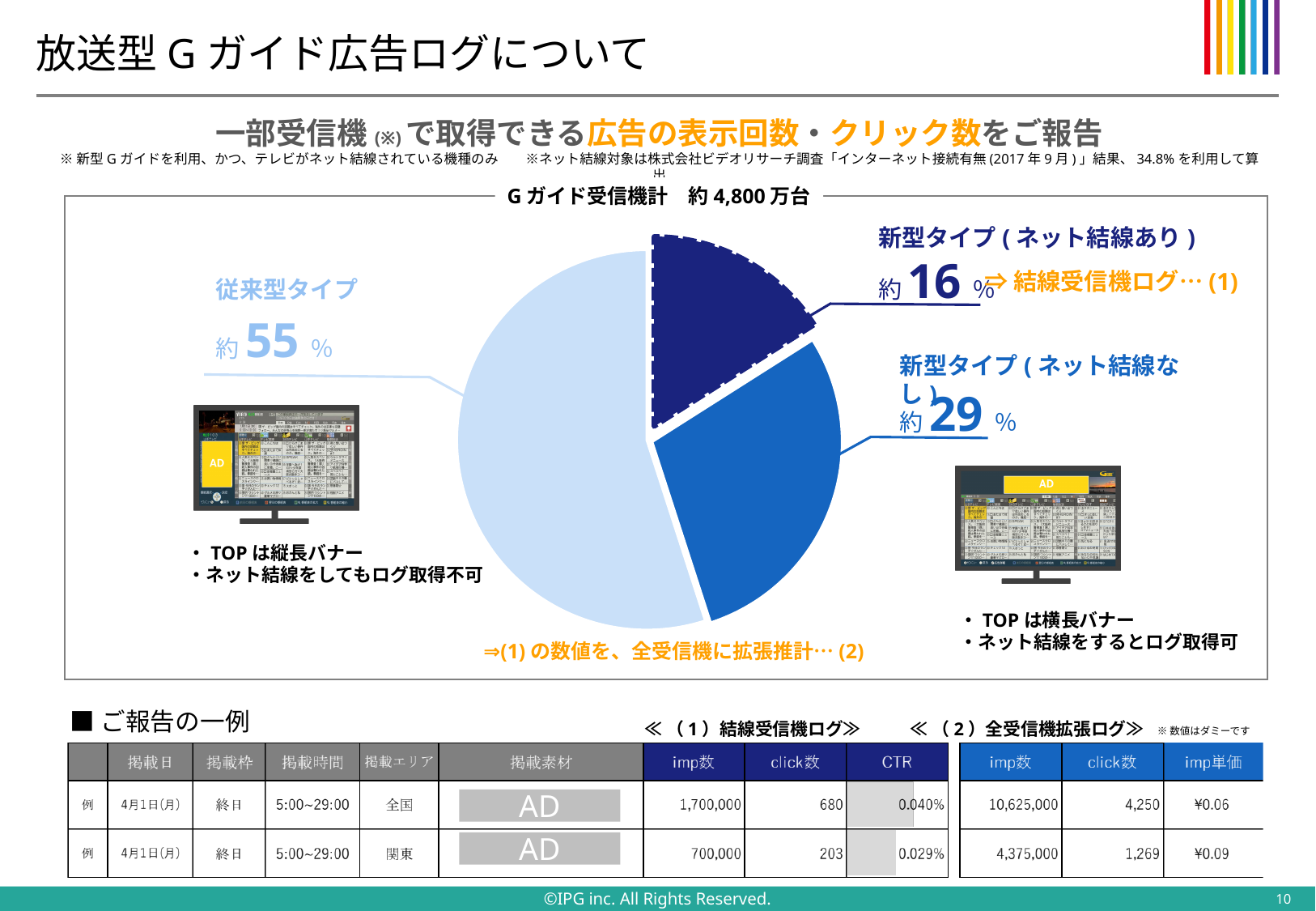
Which is larger in the pie chart: 新型タイプ(ネット結線なし) or 新型タイプ(ネット結線あり)? 新型タイプ(ネット結線なし) What share of the pie is labelled for 新型タイプ(ネット結線なし)? 約29% By how many percentage points does 新型タイプ(ネット結線なし) exceed 新型タイプ(ネット結線あり)? 13 What kind of chart is shown on the slide? pie chart What is the title written above the pie chart? Gガイド受信機計 約4,800万台 How many slices does the pie chart have? 3 Which slice of the pie chart is the smallest? 新型タイプ(ネット結線あり) Which slice of the pie chart is drawn with a dashed outline? 新型タイプ(ネット結線あり) Which slice of the pie chart is the largest? 従来型タイプ What share of the pie is labelled for 新型タイプ(ネット結線あり)? 約16% By how many percentage points does 従来型タイプ exceed 新型タイプ(ネット結線なし) in the pie chart? 26 What share of the pie is labelled for 従来型タイプ? 約55%